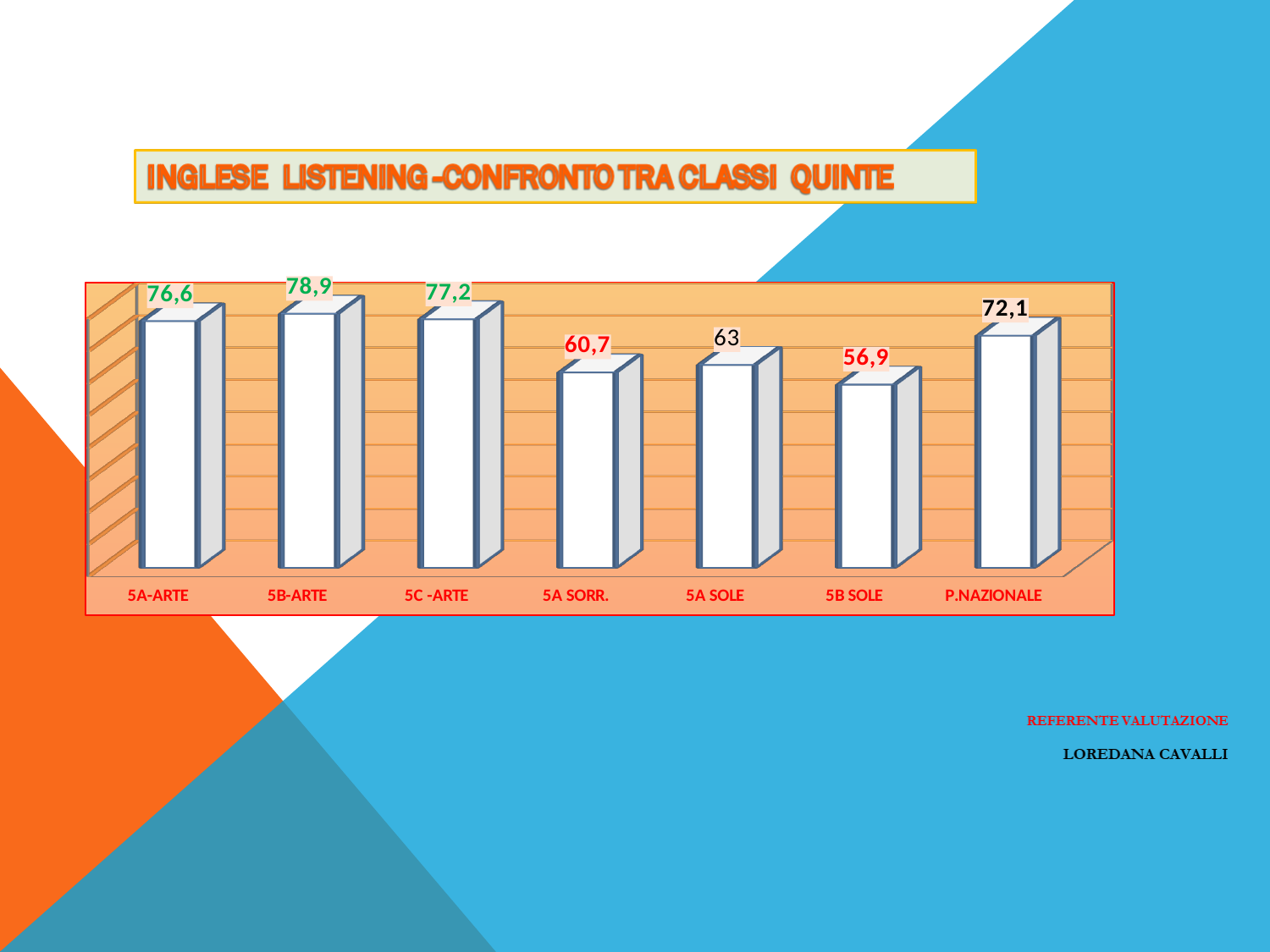
What is the value for 5A-ARTE? 76,6 Which category has the highest value? 5B-ARTE Which is larger, the value for 5C -ARTE or the value for 5A SOLE? 5C -ARTE How many categories are shown on the chart? 7 What is the value for 5A SOLE? 63 What is the difference between the values for 5B-ARTE and 5B SOLE? 22 What is the title of the chart? INGLESE LISTENING -CONFRONTO TRA CLASSI QUINTE What kind of chart is shown on the slide? bar chart What is the value for 5B SOLE? 56,9 What is the difference between the values for P.NAZIONALE and 5A SORR.? 11,4 Which category has the lowest value? 5B SOLE What is the value for P.NAZIONALE? 72,1